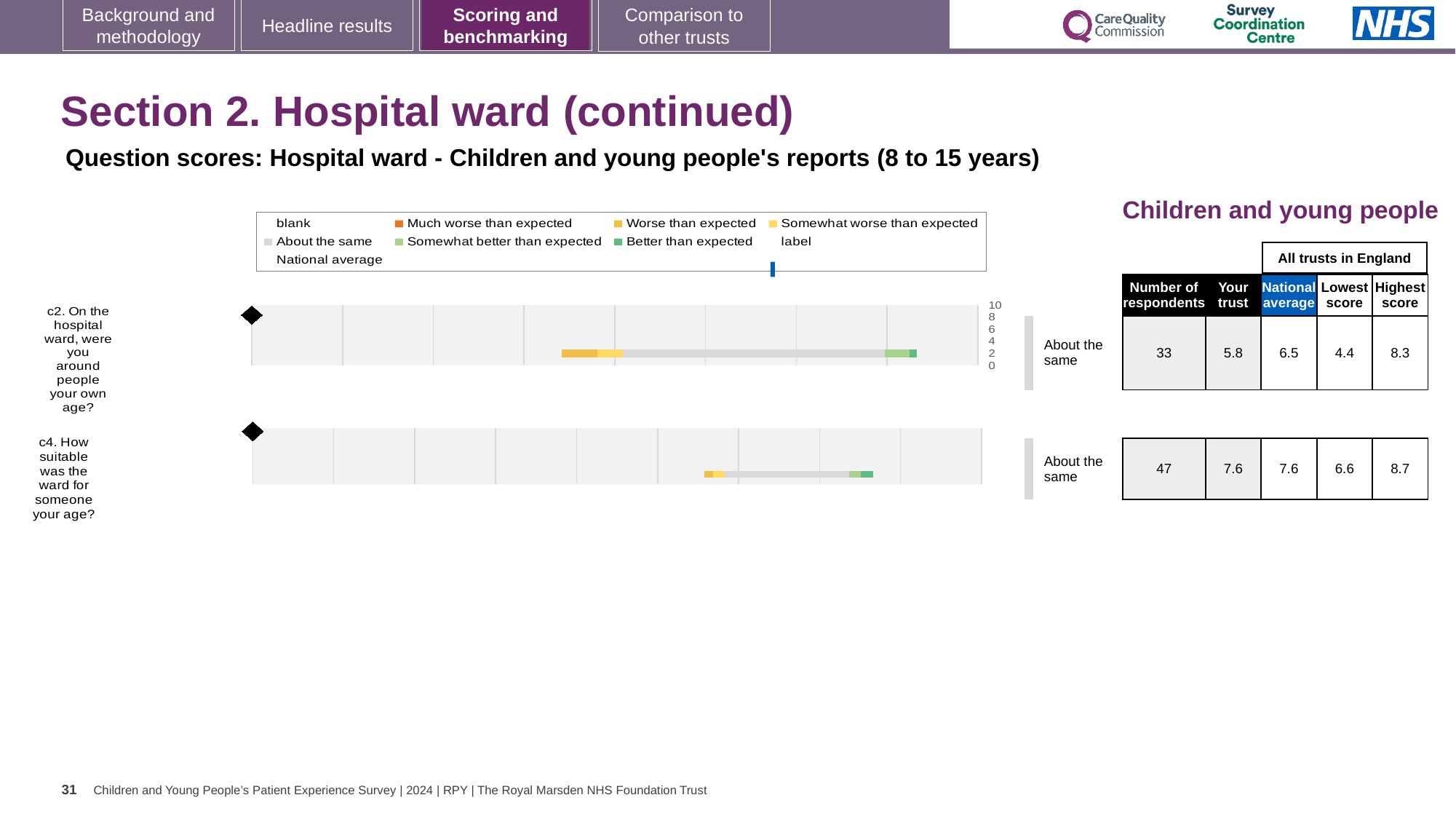
What is the highest score among all trusts in England for question c4? 8.7 What kind of chart is used to show the question scores on this slide? bar chart How many questions are plotted in the chart on this slide? 2 What is the difference between the highest and lowest scores for question c4? 2.1 Which question has the higher 'Your trust' score, c2 or c4? c4 What is the number of respondents for question c2 (On the hospital ward, were you around people your own age?)? 33 What is the national average score for question c2? 6.5 What is the difference between the national average and the 'Your trust' score for question c2? 0.7 What is the 'Your trust' score for question c2? 5.8 What benchmark category is shown for question c2? About the same For question c2, is the 'Your trust' score or the national average larger? National average What is the lowest score among all trusts in England for question c4 (How suitable was the ward for someone your age?)? 6.6